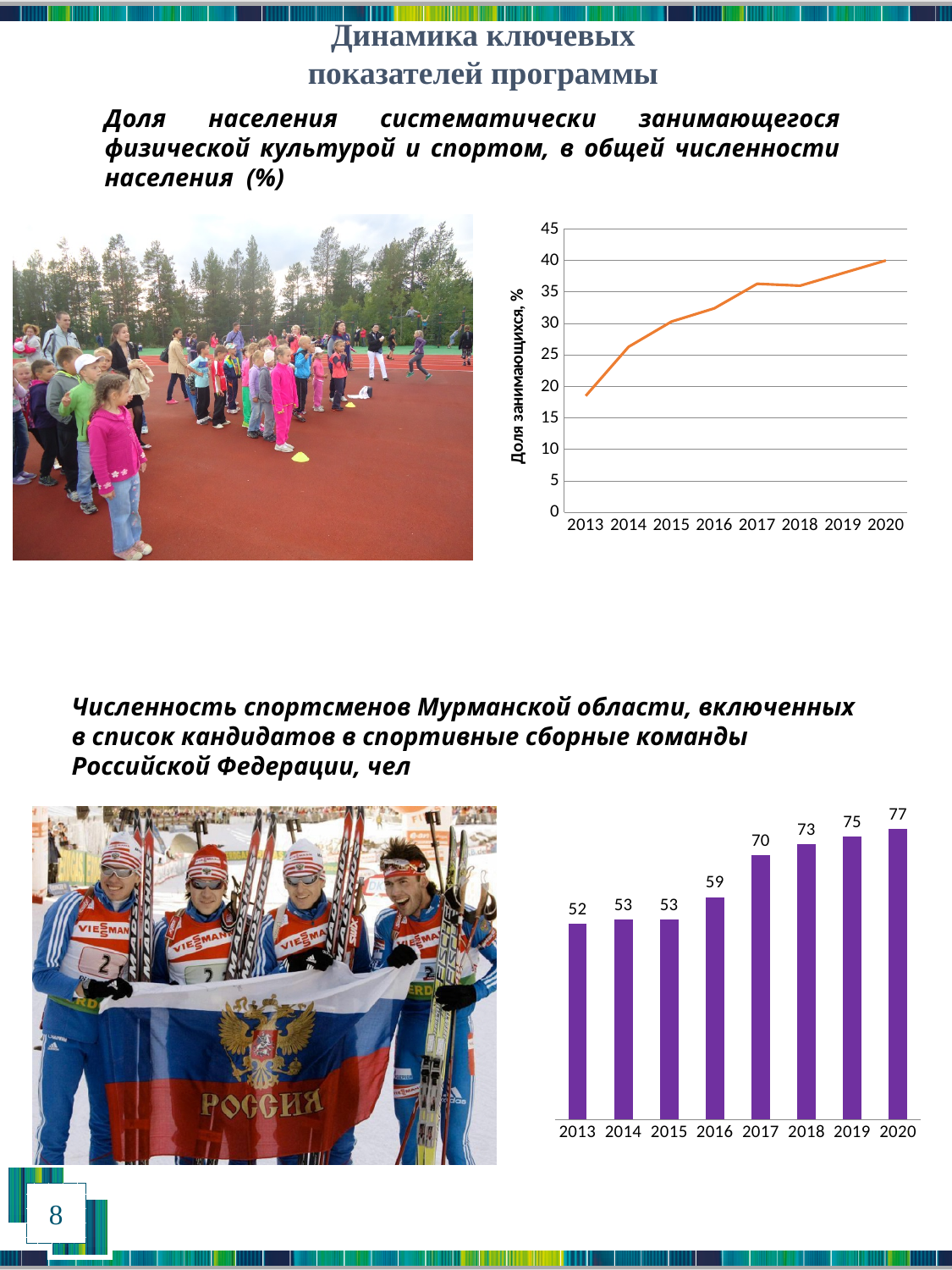
In the bottom chart (number of Murmansk region athletes on national team candidate lists), what is the value for 2017? 70 In the top chart, do the values generally rise or fall from 2013 to 2020? rise What kind of chart is the bottom chart? bar chart In the bottom chart, what is the value for 2020? 77 In the bottom chart, which is larger, the value for 2016 or the value for 2017? 2017 In the bottom chart, which year has the lowest value? 2013 What kind of chart is the top chart? line chart In the top chart, is the value for 2017 greater or less than 35? greater In the bottom chart, which year has the highest value? 2020 In the top chart (share of population systematically engaged in physical culture and sport), is the value for 2013 greater or less than 20? less In the bottom chart, what is the difference between the values for 2020 and 2013? 25 How many years are shown in the bottom chart? 8